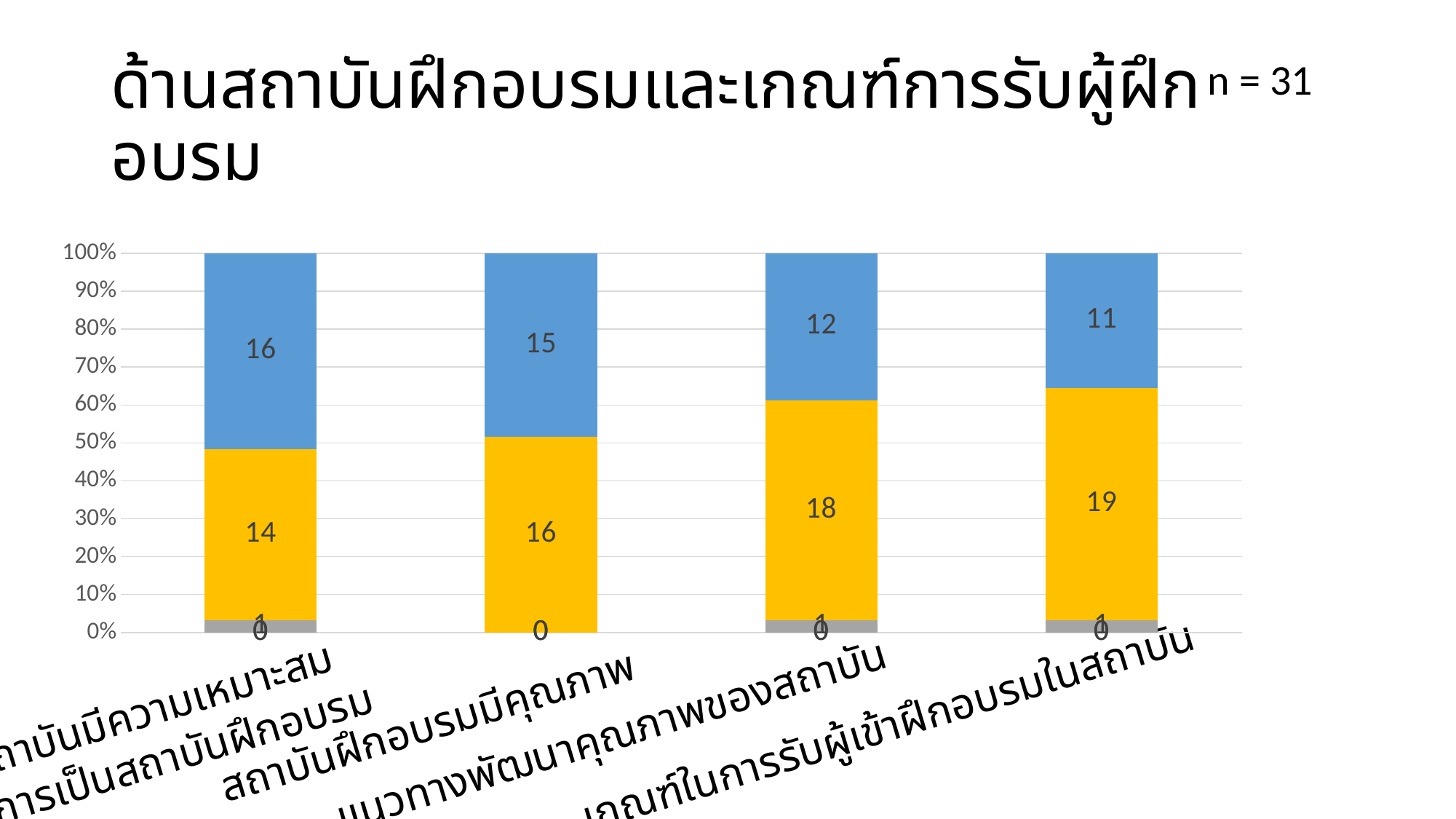
Which bar has the smallest blue segment value? the rightmost bar (11) Which is larger: the blue value in the leftmost bar or the blue value in the third bar from the left? the leftmost bar What sample size (n) is shown on the slide? n = 31 What kind of chart is shown on the slide? stacked bar chart Do the blue segment values rise or fall from left to right across the bars? fall In the rightmost bar, what is the difference between the yellow value and the blue value? 8 Which bar has the largest yellow segment value? the rightmost bar (19) What is the value of the yellow segment in the rightmost bar? 19 How many bars (categories) are plotted in the chart? 4 What is the value of the yellow segment in the bar labelled สถาบันฝึกอบรมมีคุณภาพ? 16 What is the value of the blue segment in the leftmost bar? 16 What is the value of the blue segment in the third bar from the left? 12